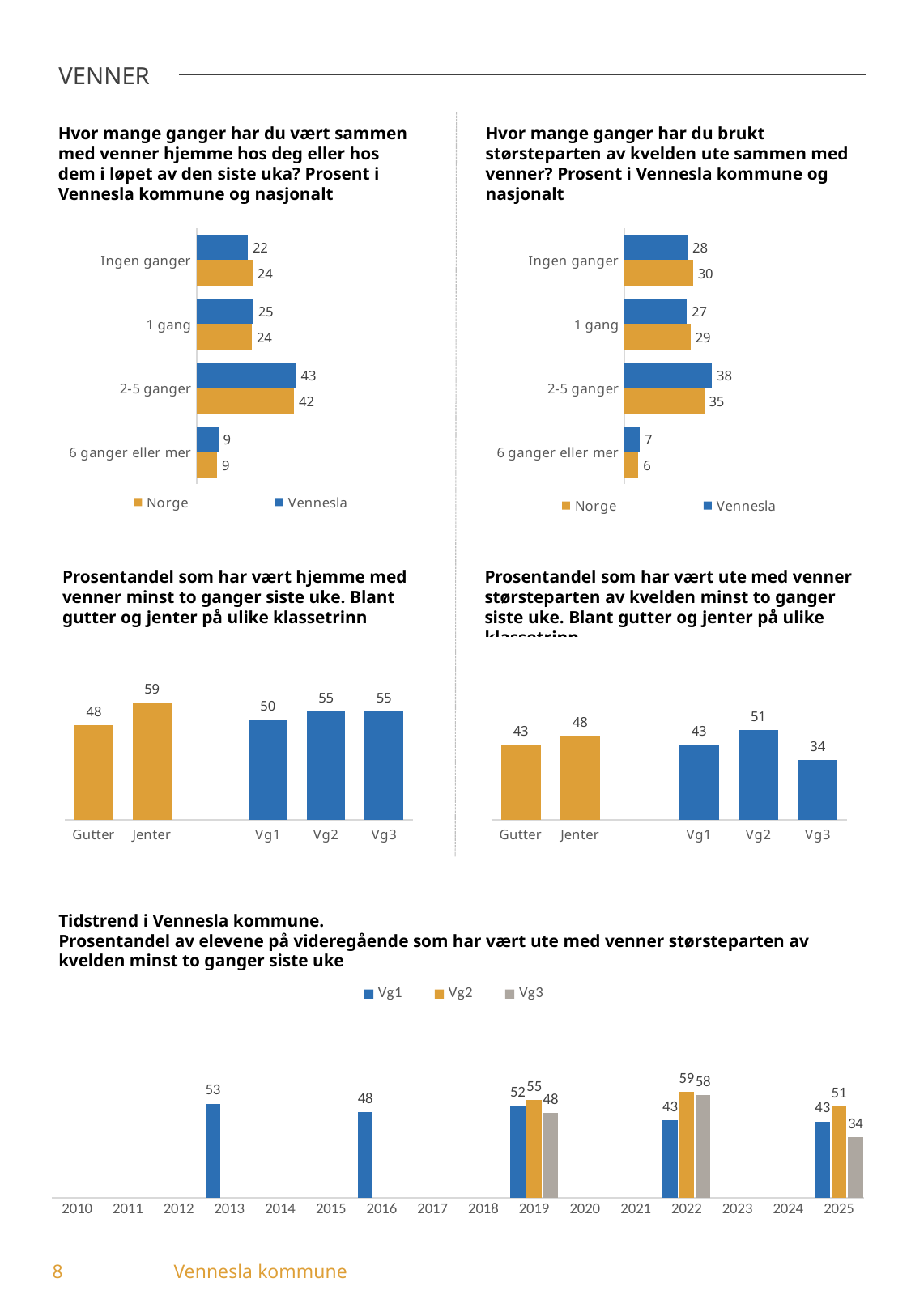
In the top-left chart about being with friends at home, what is the Vennesla value for '2-5 ganger'? 43 In the middle-right chart 'Prosentandel som har vært ute med venner størsteparten av kvelden minst to ganger siste uke', which category has the highest value? Vg2 In the bottom chart 'Tidstrend i Vennesla kommune', what is the Vg3 value for 2022? 58 In the top-left chart about being with friends at home, what is the Norge value for 'Ingen ganger'? 24 In the bottom chart 'Tidstrend i Vennesla kommune', which is larger: the Vg1 value for 2013 or the Vg1 value for 2025? 2013 In the top-right chart about spending the evening out with friends, which category has the lowest Vennesla value? 6 ganger eller mer In the middle-left chart 'Prosentandel som har vært hjemme med venner minst to ganger siste uke', what is the value for Jenter? 59 In the top-right chart about spending the evening out with friends, what is the difference between the Vennesla and Norge values for 'Ingen ganger'? 2 In the bottom chart 'Tidstrend i Vennesla kommune', how many series does the legend list? 3 In the top-right chart about spending the evening out with friends, what is the Norge value for '2-5 ganger'? 35 In the middle-left chart 'Prosentandel som har vært hjemme med venner minst to ganger siste uke', which category has the lowest value? Gutter In the middle-right chart 'Prosentandel som har vært ute med venner størsteparten av kvelden minst to ganger siste uke', what is the difference between Vg2 and Vg3? 17